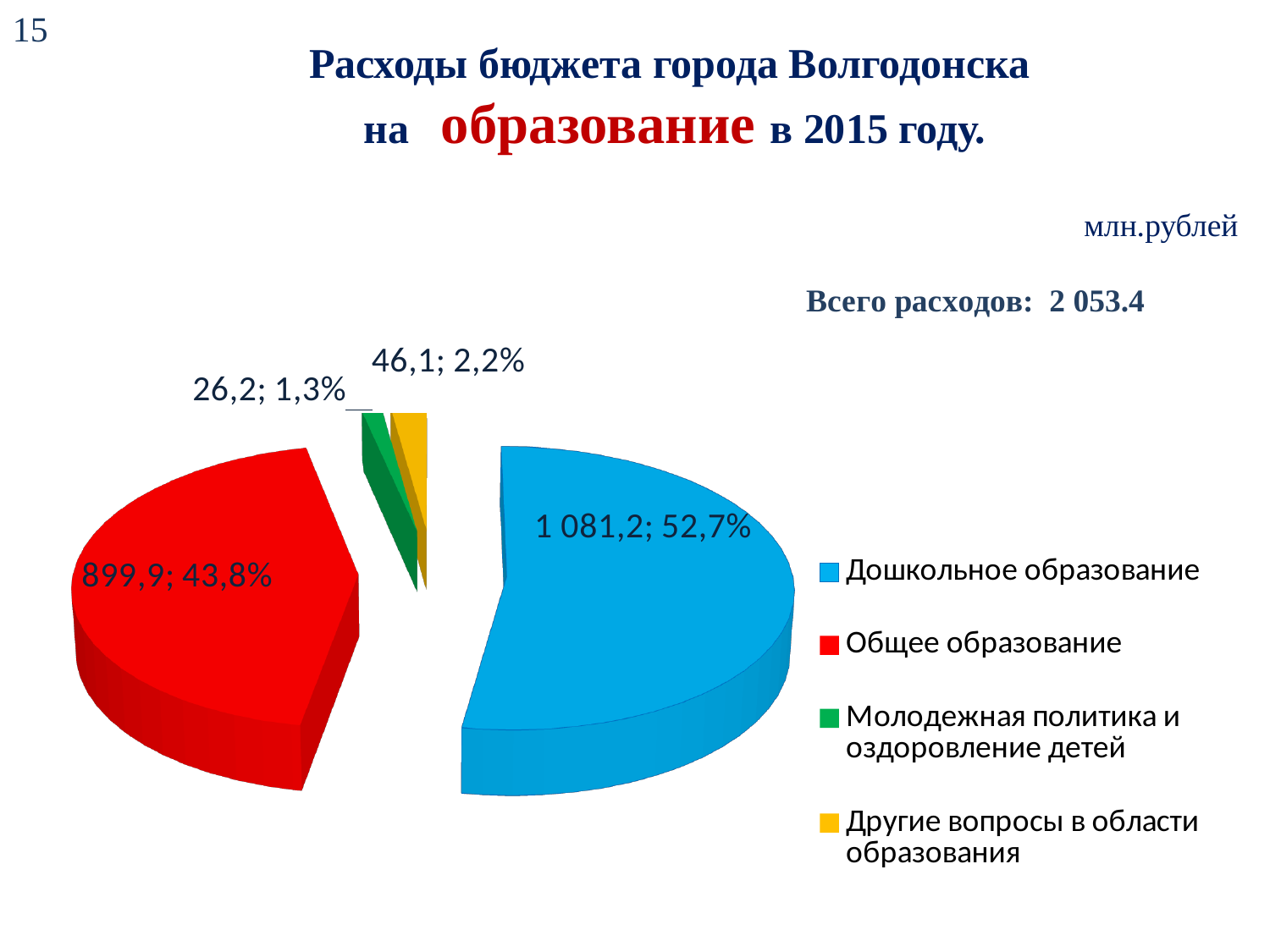
What is the value for Дошкольное образование? 1 081,2 Which category has the smallest slice? Молодежная политика и оздоровление детей What is the value for Молодежная политика и оздоровление детей? 26,2 What share of the pie does Общее образование take? 43,8% What colour is the slice for Общее образование? red How many slices does the pie chart have? 4 How many entries does the legend list? 4 Which category has the largest slice? Дошкольное образование What is the value for Другие вопросы в области образования? 46,1 What kind of chart is shown on the slide? pie chart What is the value for Общее образование? 899,9 What share of the pie does Другие вопросы в области образования take? 2,2%